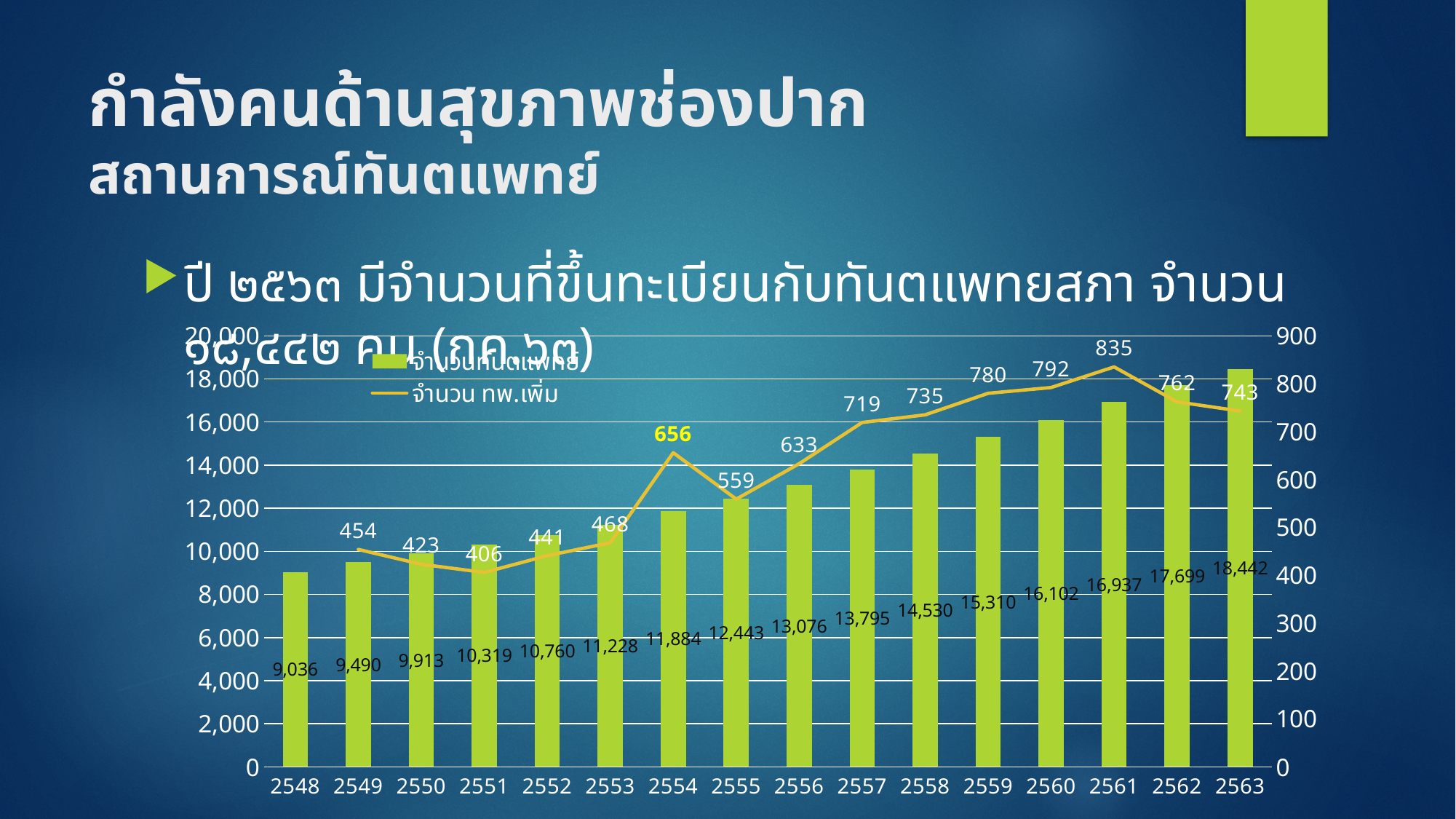
How many years are shown on the x axis? 16 What colour are the bars in the chart? green How many series does the legend list? 2 What is the number of dentists (bar value) for 2563? 18,442 Do the bar values rise or fall from 2548 to 2563? rise In which year does the line series (จำนวน ทพ.เพิ่ม) reach its highest value? 2561 What is the value of the line series (จำนวน ทพ.เพิ่ม) for 2554? 656 What is the value of the line series (จำนวน ทพ.เพิ่ม) for 2561? 835 In which year is the line series (จำนวน ทพ.เพิ่ม) at its lowest value? 2551 What is the difference between the bar values for 2563 and 2562? 743 Which year has the larger line value, 2555 or 2556? 2556 What is the bar value for 2548? 9,036